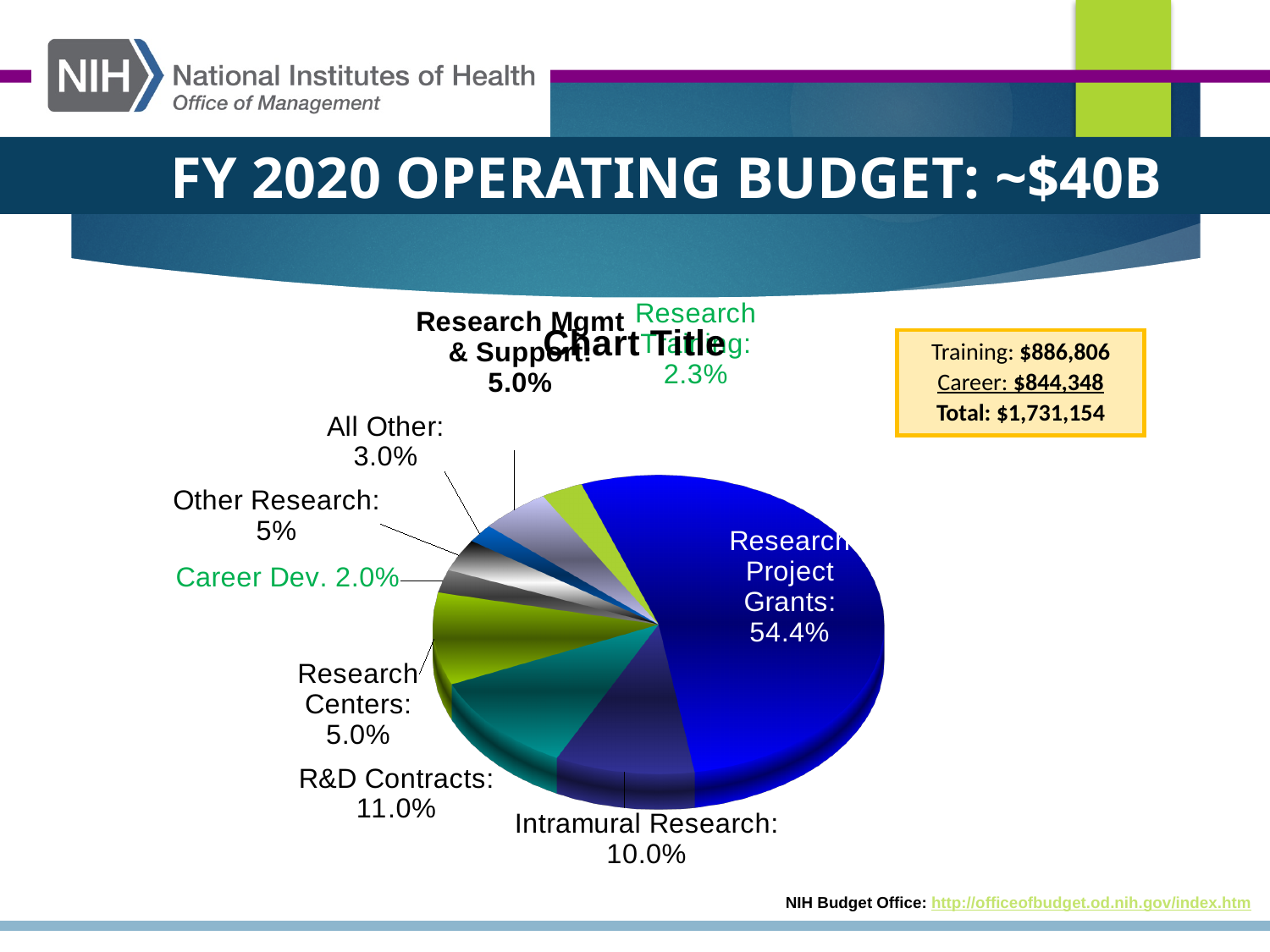
Which is larger, R&D Contracts or Intramural Research? R&D Contracts What kind of chart is shown on the slide? pie chart What share of the pie is Research Training? 2.3% Which slice of the pie is the smallest? Career Dev. What share of the pie is Research Project Grants? 54.4% What share of the pie is R&D Contracts? 11.0% Which slice of the pie is the largest? Research Project Grants What is the difference between the Research Project Grants share and the R&D Contracts share? 43.4% What share of the pie is Intramural Research? 10.0% What share of the pie is All Other? 3.0% What share of the pie is Career Dev.? 2.0% How many slices does the pie chart have? 9